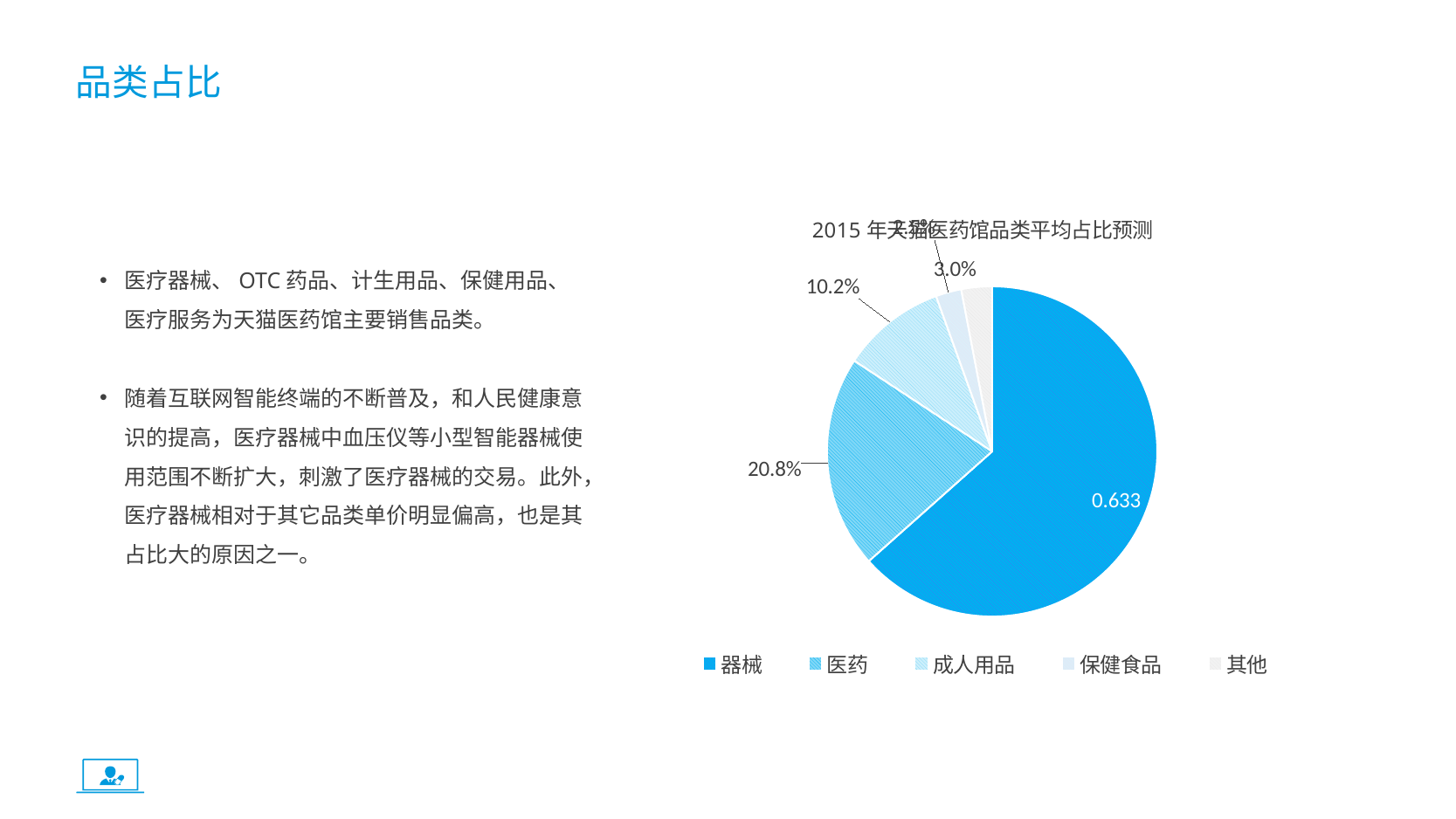
Which category has the largest slice of the pie? 器械 What value is printed on the 器械 slice of the pie chart? 0.633 What kind of chart is shown on the slide? pie chart Which slice is larger, 医药 or 成人用品? 医药 Which category is listed first in the pie chart's legend? 器械 What percentage is shown for the 医药 slice? 20.8% What percentage is shown for the 成人用品 slice? 10.2% What is the difference between the 医药 and 成人用品 percentages? 10.6% Which legend entry is shown in grey? 其他 How many categories does the pie chart's legend list? 5